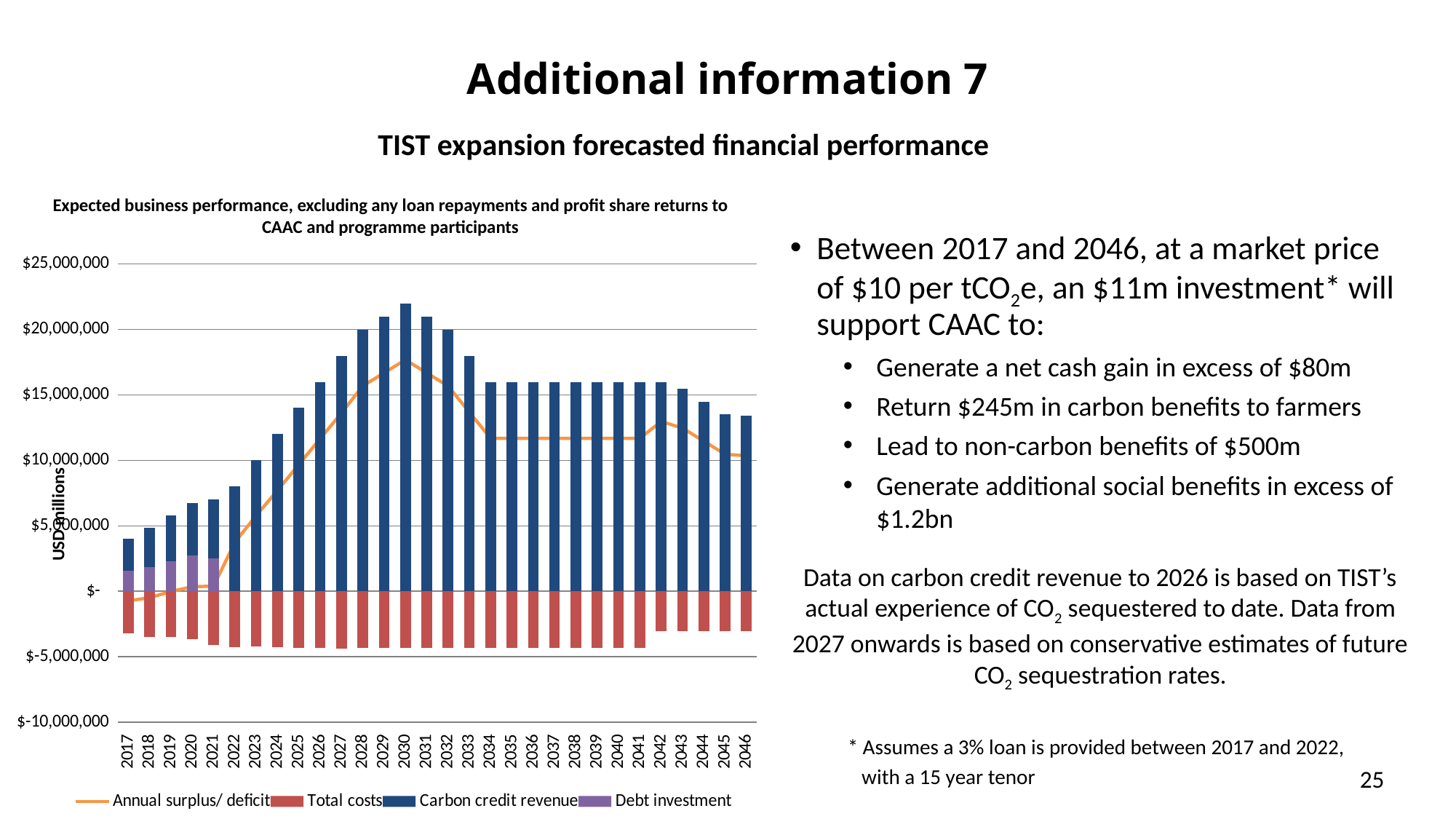
Does Carbon credit revenue rise or fall from 2017 to 2030? Rise In how many years does the chart show a Debt investment bar? 5 What kind of chart is used to show Carbon credit revenue? Bar chart How many years are shown on the x axis of the chart? 30 In which year is Carbon credit revenue lowest? 2017 Is the Carbon credit revenue for 2030 greater or less than $20,000,000? greater In which year is Carbon credit revenue highest? 2030 Which year has the larger Carbon credit revenue, 2042 or 2046? 2042 Is the Carbon credit revenue for 2046 greater or less than $15,000,000? less Is the Carbon credit revenue for 2017 greater or less than $5,000,000? less How many series does the chart legend list? 4 What kind of chart element is used to show Annual surplus/ deficit? Line